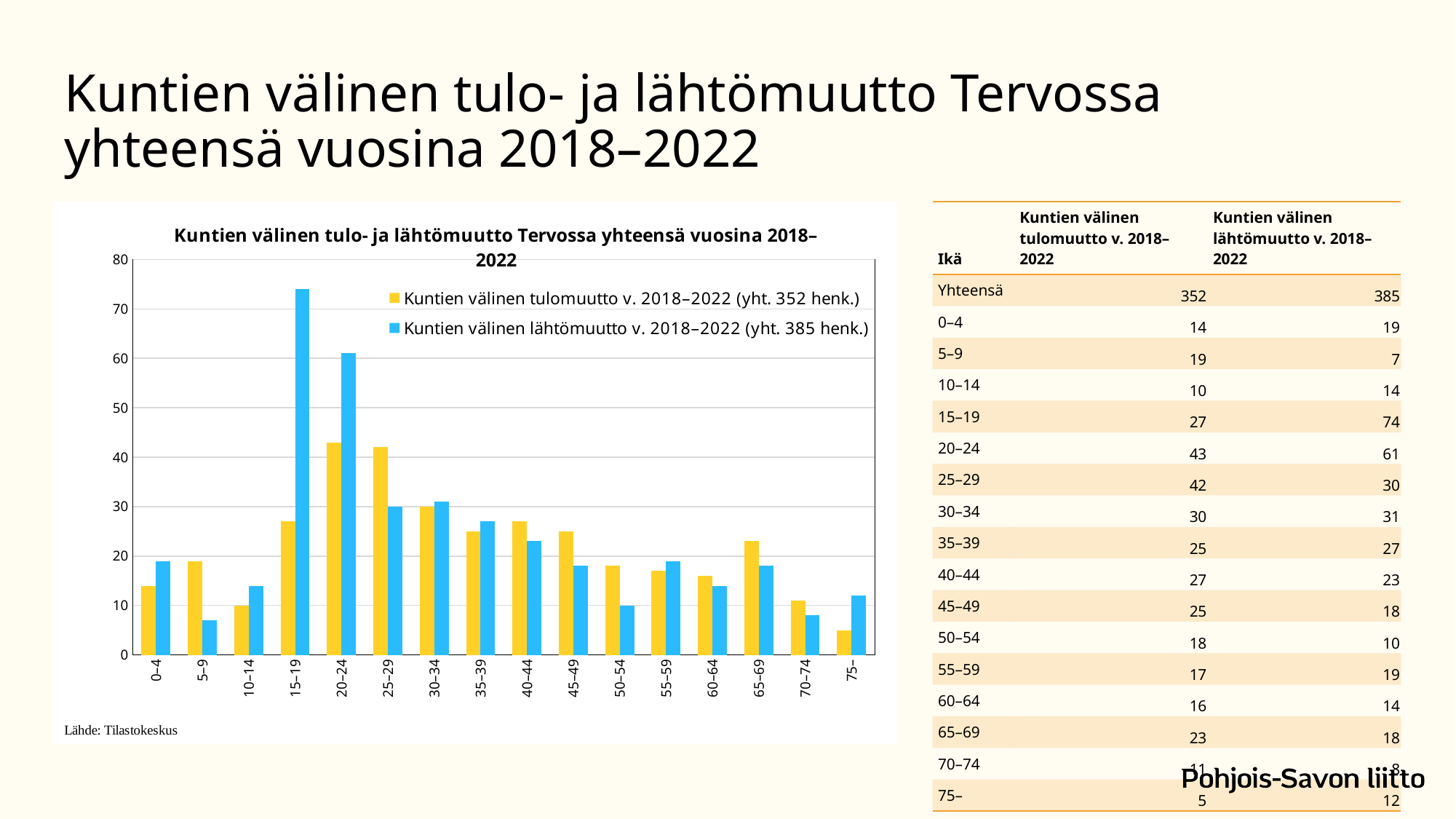
What is the value of Kuntien välinen tulomuutto v. 2018–2022 for the 20–24 age group? 43 For the 25–29 age group, which is larger: tulomuutto or lähtömuutto? tulomuutto How many age groups are shown on the x axis of the chart? 16 Is the value of Kuntien välinen tulomuutto for the 65–69 age group greater or less than 20? greater Which age group has the lowest value for Kuntien välinen tulomuutto v. 2018–2022? 75– What is the value of Kuntien välinen lähtömuutto v. 2018–2022 for the 5–9 age group? 7 According to the legend, what is the total number of persons for Kuntien välinen tulomuutto v. 2018–2022? 352 henk. How many series does the chart's legend list? 2 What kind of chart is shown on the slide? bar chart Which age group has the highest value for Kuntien välinen lähtömuutto v. 2018–2022? 15–19 For the 15–19 age group, how much larger is lähtömuutto than tulomuutto? 47 Do the values of Kuntien välinen tulomuutto rise or fall from the 45–49 age group to the 60–64 age group? fall